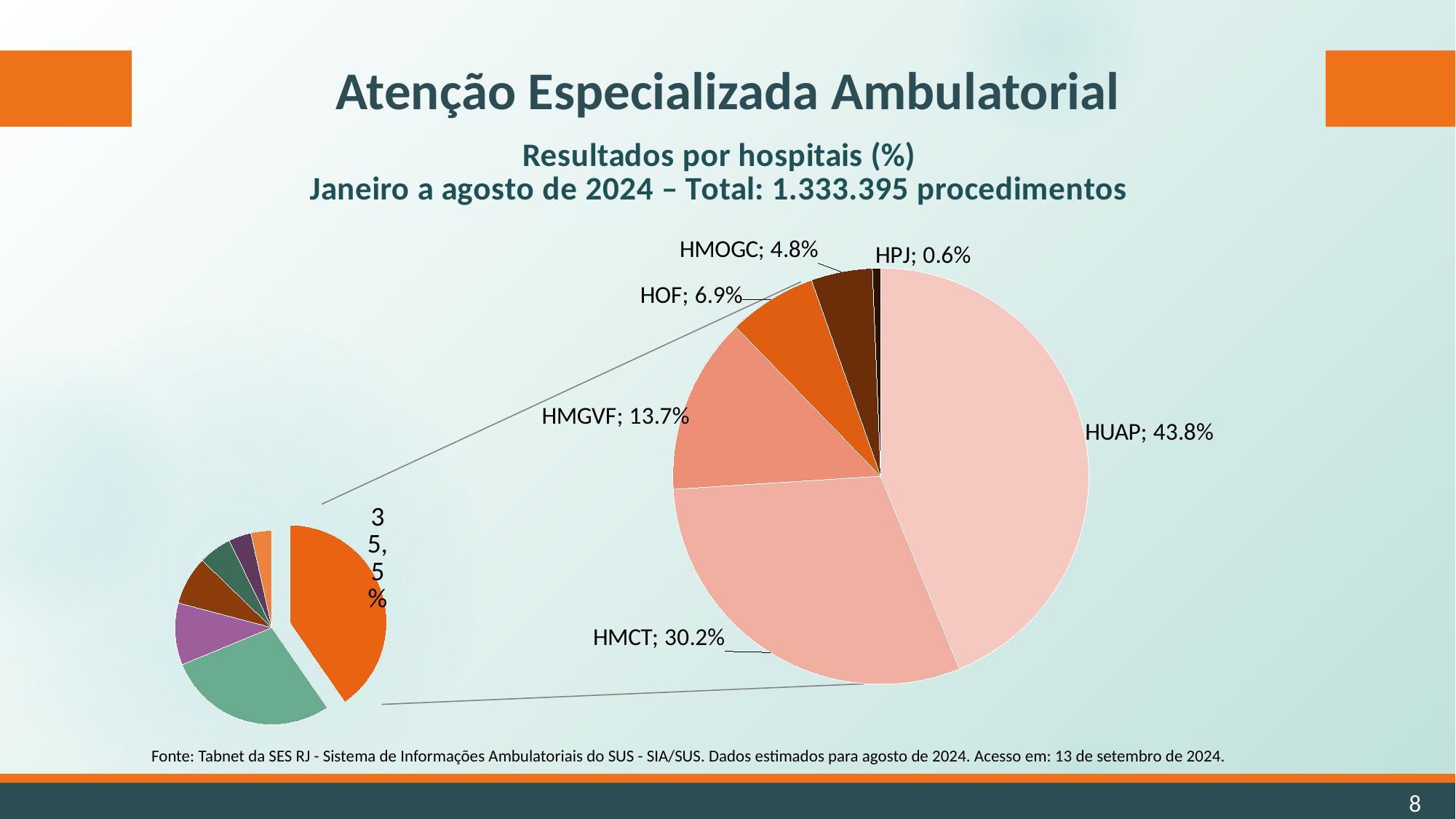
In the secondary (right-hand) pie, which is larger, the share for HMGVF or the share for HOF? HMGVF In the secondary (right-hand) pie, what is the difference in percentage points between HUAP and HMCT? 13.6 In the secondary (right-hand) pie, which hospital has the largest share? HUAP In the secondary (right-hand) pie, what percentage is shown for HPJ? 0.6% How many labeled slices does the secondary (right-hand) pie have? 6 In the secondary (right-hand) pie, what percentage is shown for HMGVF? 13.7% In the secondary (right-hand) pie, what percentage is shown for HUAP? 43.8% In the secondary (right-hand) pie, which hospital has the smallest share? HPJ In the secondary (right-hand) pie, what is the difference in percentage points between HOF and HMOGC? 2.1 What type of chart is shown on the slide? Pie chart What percentage label is shown on the exploded orange slice of the main (left-hand) pie? 35,5% In the secondary (right-hand) pie, what percentage is shown for HMCT? 30.2%